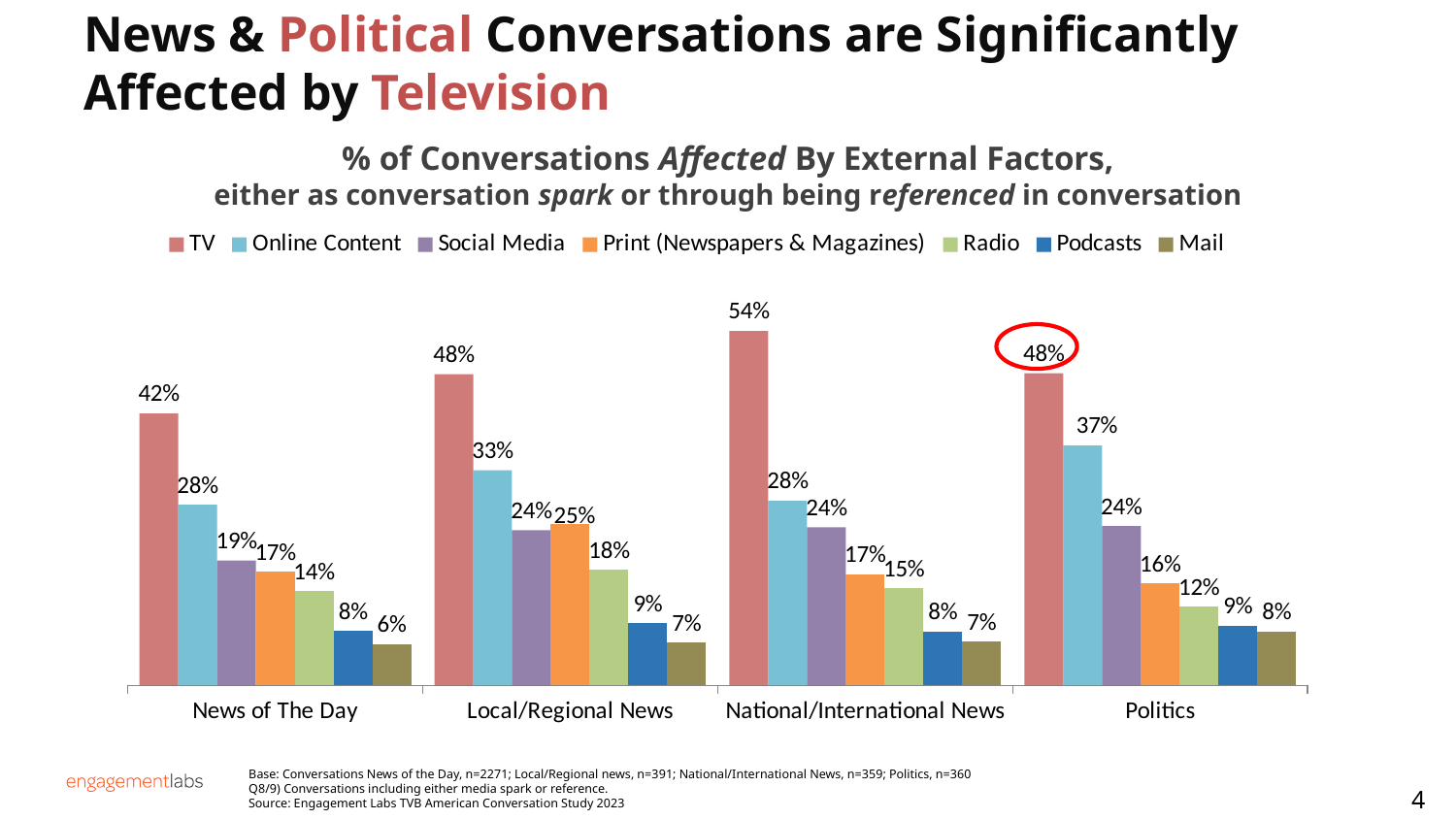
Which is larger for Local/Regional News: Social Media or Print (Newspapers & Magazines)? Print (Newspapers & Magazines) What is the value for Print (Newspapers & Magazines) in the Local/Regional News category? 25% Which category has the highest TV value? National/International News What is the value for Online Content in the Politics category? 37% How many series does the legend list? 7 What kind of chart is shown on the slide? Bar chart Which value on the chart is circled in red? 48% (TV, Politics) Which external factor has the lowest value in the News of The Day category? Mail How many categories are shown on the x axis? 4 What is the difference between the TV value and the Online Content value for National/International News? 26 percentage points What is the value for Radio in the Politics category? 12% What percentage of News of The Day conversations are affected by TV? 42%